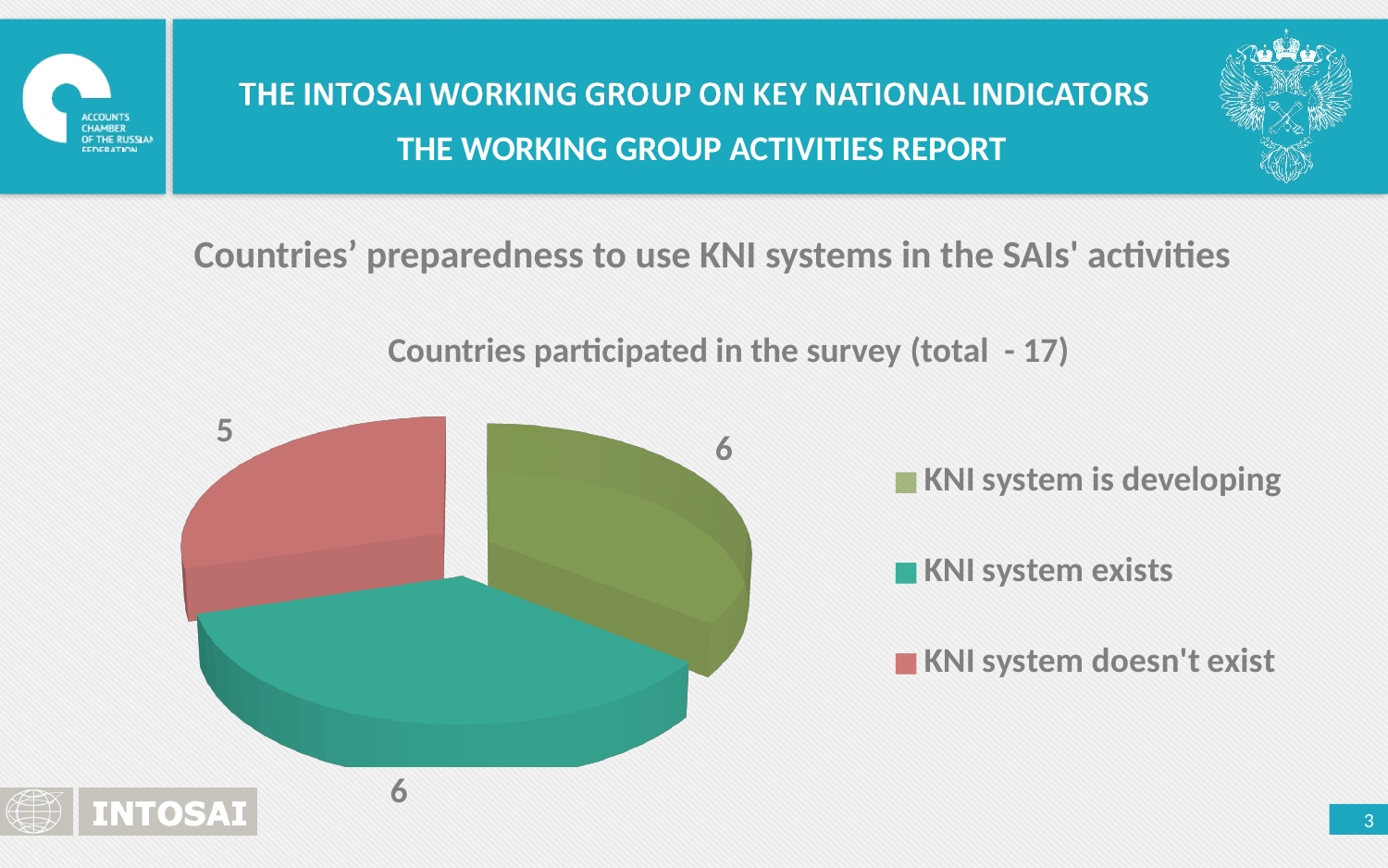
What type of chart is shown on the slide? Pie chart Which is larger: the number of countries where a KNI system exists or where a KNI system doesn't exist? KNI system exists How many countries reported that a KNI system exists? 6 What is the difference between the number of countries where a KNI system exists and where it doesn't exist? 1 How many countries reported that a KNI system doesn't exist? 5 What is the title of the chart? Countries participated in the survey (total - 17) Which category has the smallest slice of the pie? KNI system doesn't exist What is the total number of countries represented in the pie chart? 17 How many countries reported that a KNI system is developing? 6 Which colour represents the 'KNI system doesn't exist' category? Red How many entries does the legend list? 3 How many slices does the pie chart have? 3